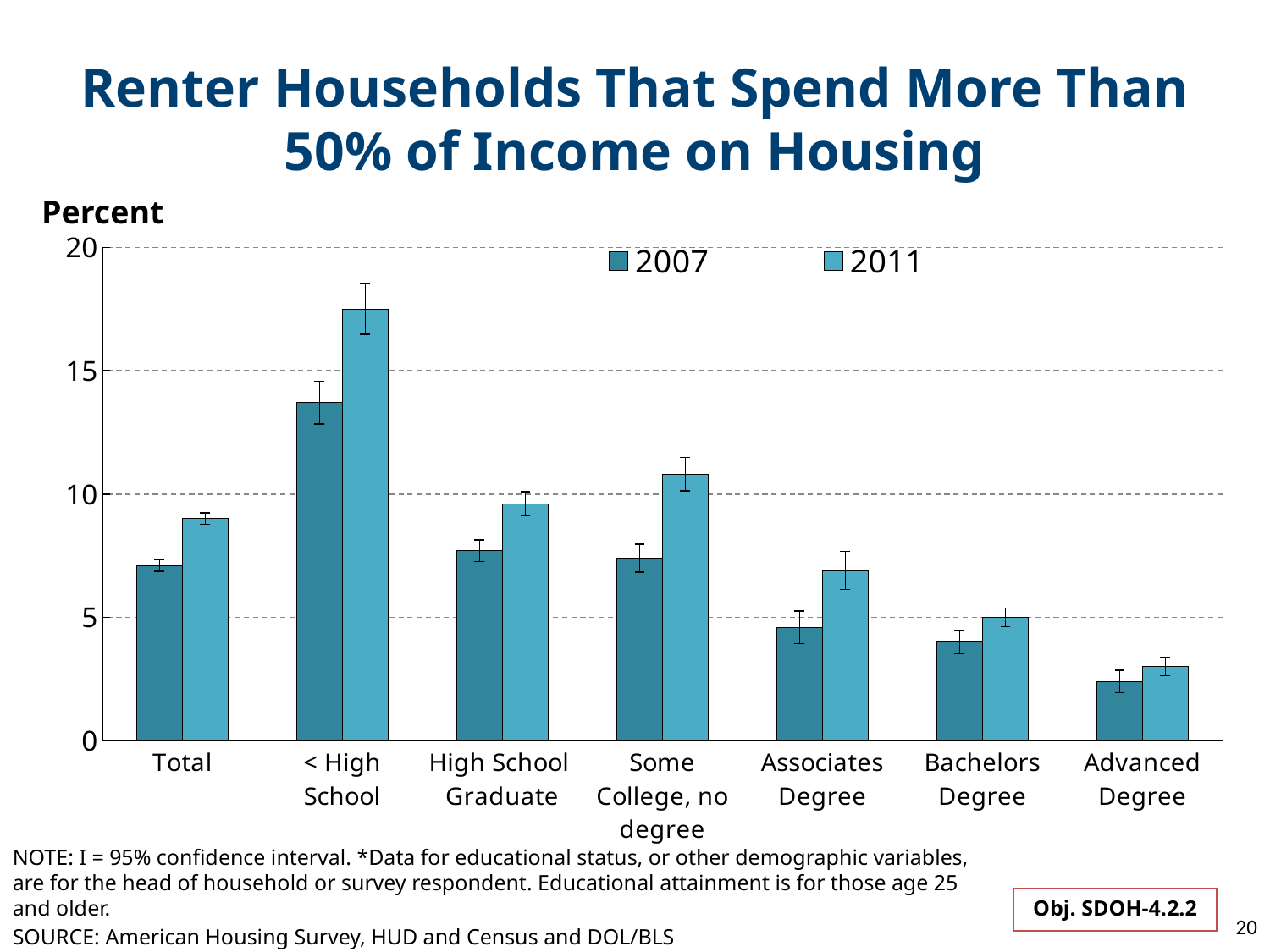
Is the 2007 value for Associates Degree greater or less than 5? less Is the 2007 value for < High School greater or less than 15? less What kind of chart is shown on the slide? bar chart Which category has the lowest 2007 value? Advanced Degree Is the 2011 value for < High School greater or less than 15? greater What unit is shown on the y axis label? Percent How many series does the legend list? 2 How many categories are shown on the x axis? 7 Which is larger for Total: the 2007 value or the 2011 value? 2011 From Some College, no degree to Advanced Degree, do the 2011 values rise or fall along the x axis? fall Which category has the highest 2011 value? < High School